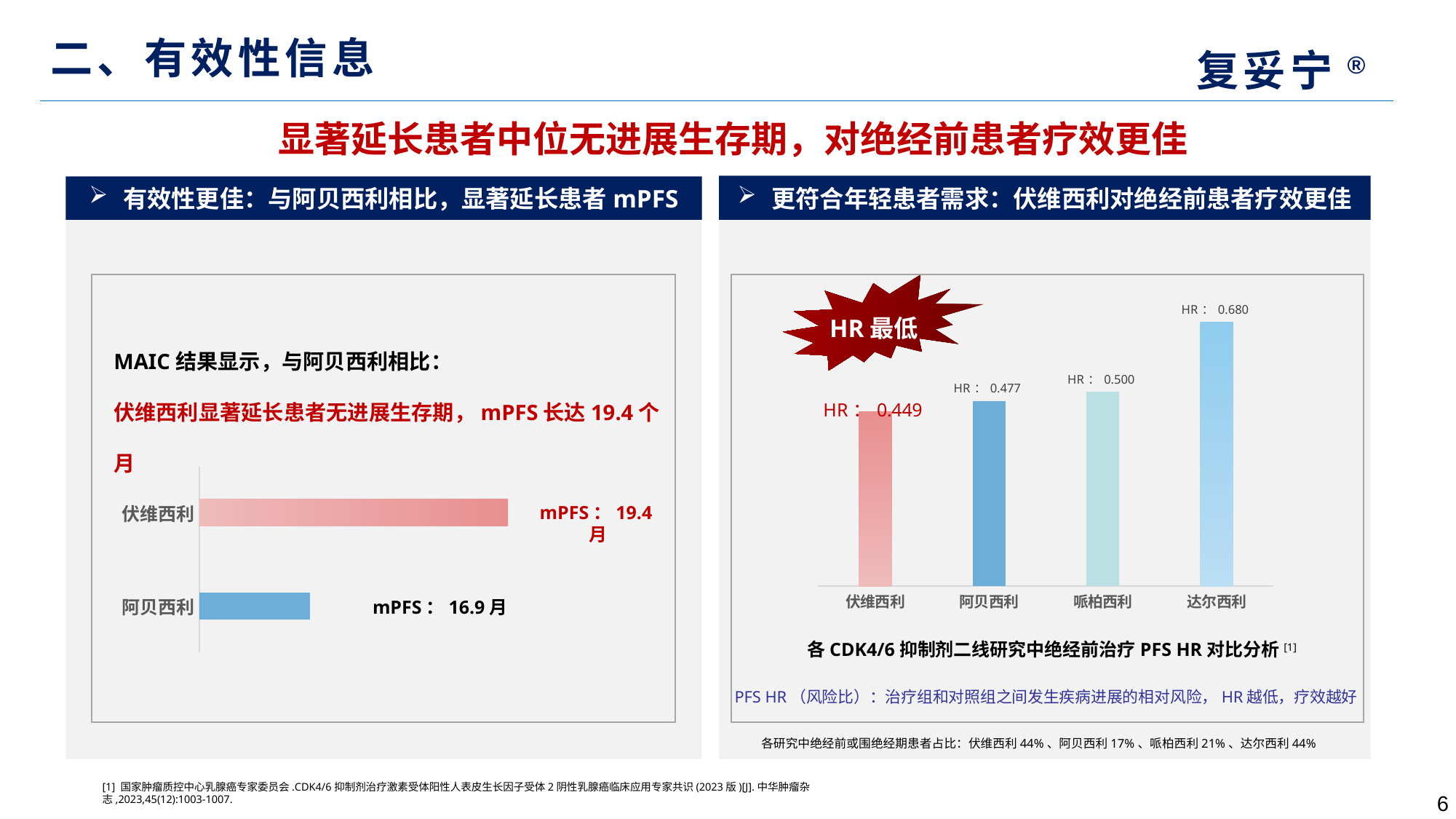
In the left mPFS bar chart, what is the mPFS value for 伏维西利? 19.4 月 In the right PFS HR chart, which drug has the highest HR? 达尔西利 In the right PFS HR chart, what is the difference in HR between 达尔西利 and 伏维西利? 0.231 In the right PFS HR chart, how many drugs are compared? 4 In the right PFS HR chart, what is the HR value for 伏维西利? 0.449 In the left mPFS bar chart, what is the mPFS value for 阿贝西利? 16.9 月 What kind of chart is the left mPFS chart? Bar chart In the left mPFS bar chart, what is the difference in mPFS between 伏维西利 and 阿贝西利? 2.5 月 In the right PFS HR chart, which drug has the lowest HR? 伏维西利 In the left mPFS bar chart, which drug has the longer mPFS, 伏维西利 or 阿贝西利? 伏维西利 In the right PFS HR chart, what is the HR value for 哌柏西利? 0.500 In the right PFS HR chart, what is the HR value for 达尔西利? 0.680